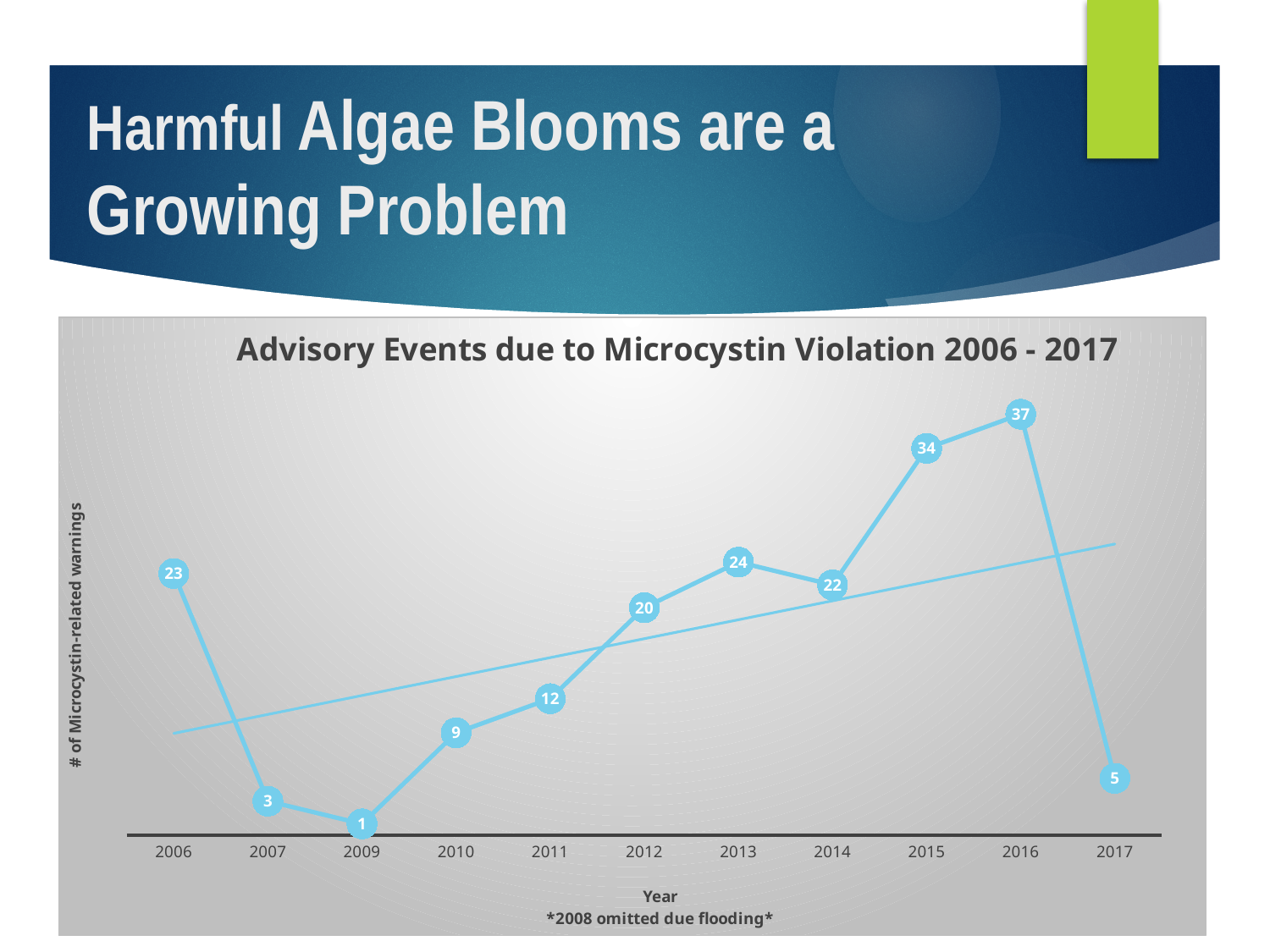
What kind of chart is shown on the slide? Line chart What is the value for 2017? 5 Which year has the lowest number of Microcystin-related warnings? 2009 What is the value for 2009? 1 Which year has the highest number of Microcystin-related warnings? 2016 What is the difference between the values for 2006 and 2007? 20 Which is larger, the value for 2013 or the value for 2014? 2013 What is the title of the chart? Advisory Events due to Microcystin Violation 2006 - 2017 What is the value for 2016? 37 What is the difference between the values for 2016 and 2017? 32 Do the values rise or fall from 2009 to 2013? Rise How many years are plotted on the x axis? 11